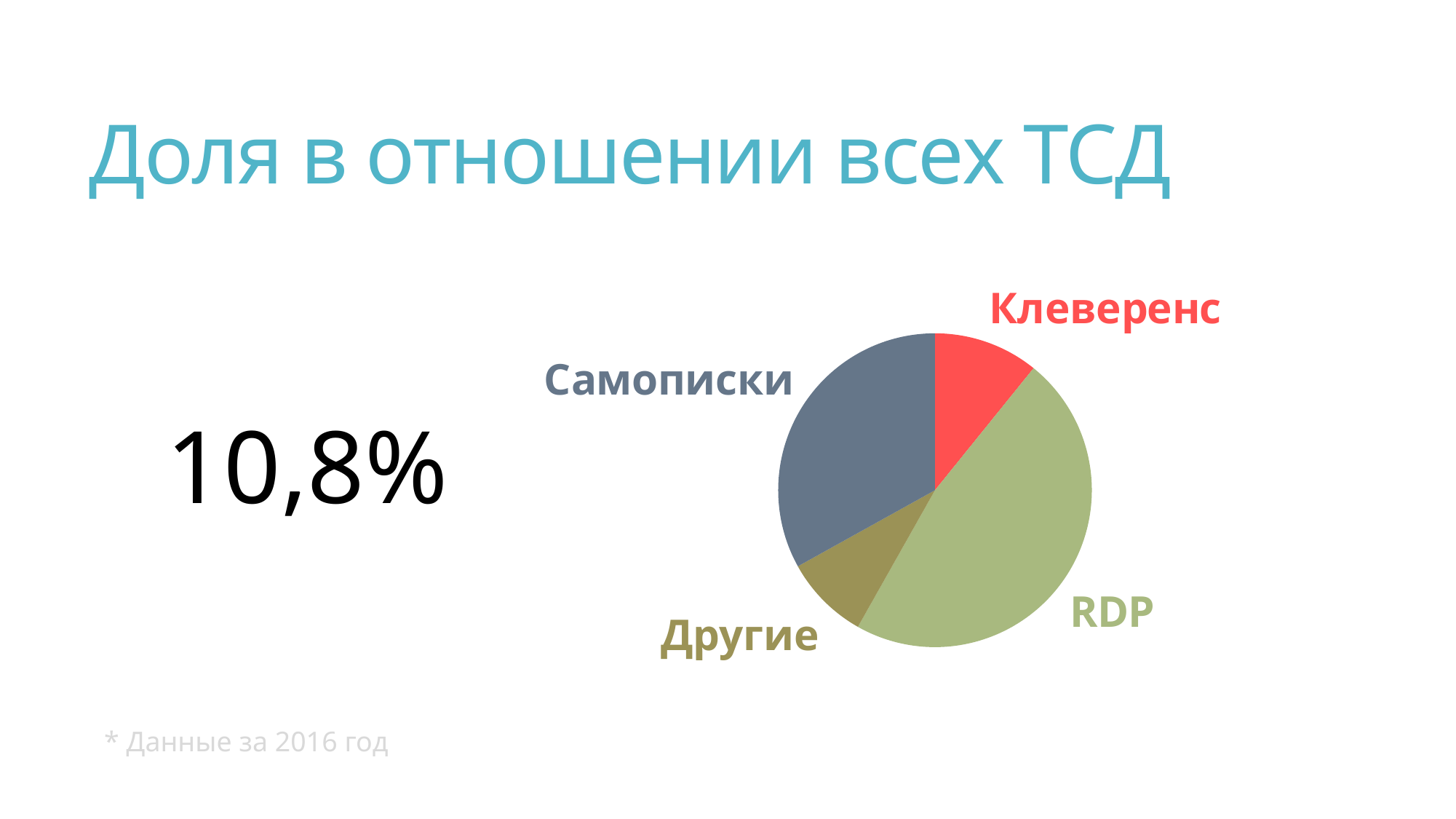
Which category has the largest slice of the pie chart? RDP Which slice is larger, RDP or Самописки? RDP What colour is the Клеверенс slice of the pie chart? red Which slice is larger, RDP or Другие? RDP What kind of chart is shown on the slide? pie chart Which slice is larger, Самописки or Клеверенс? Самописки How many slices does the pie chart have? 4 What is the title of the slide containing the pie chart? Доля в отношении всех ТСД